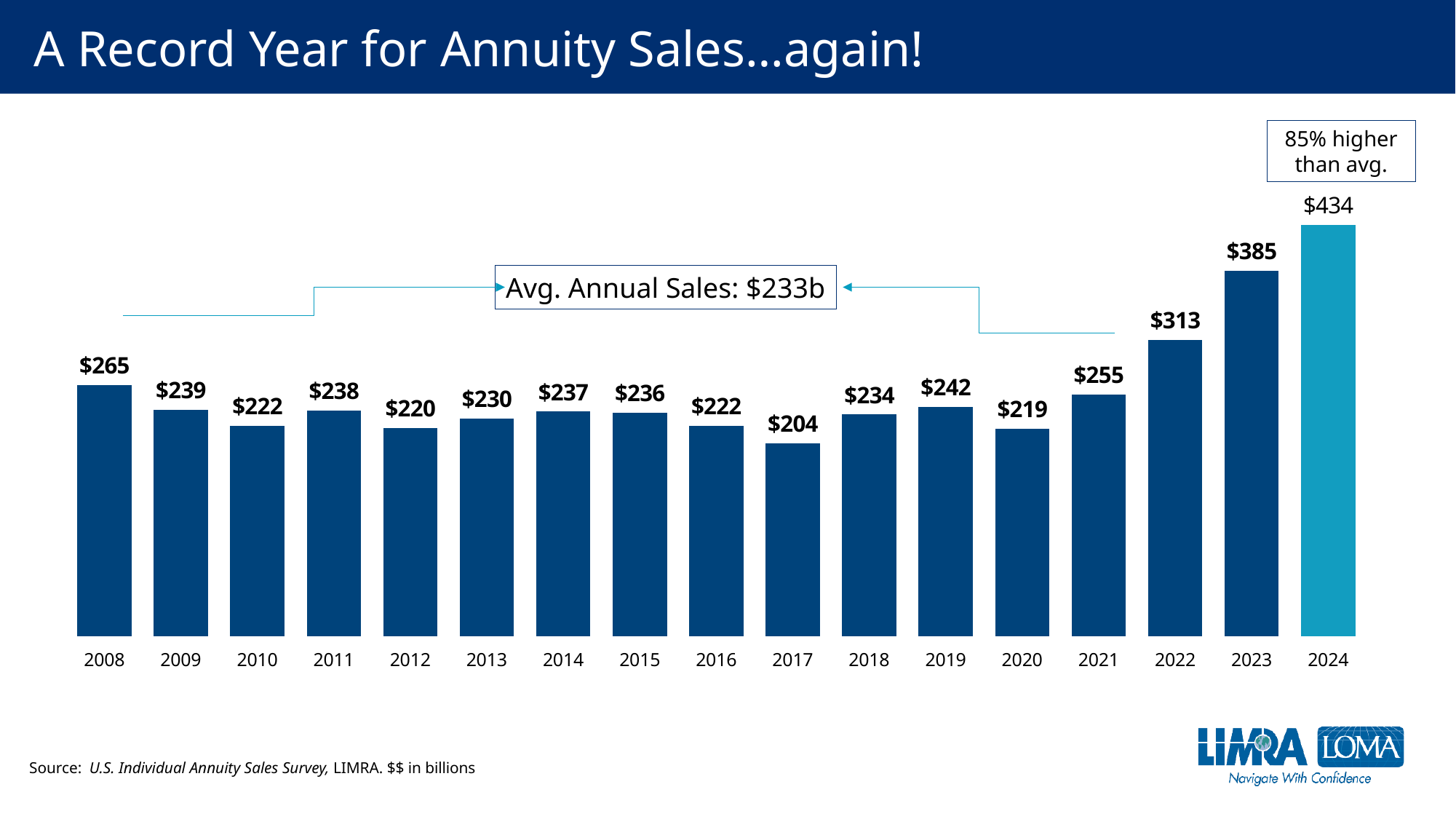
How many years are shown on the chart? 17 What is the annuity sales value for 2008? $265 What is the annuity sales value for 2017? $204 What is the difference between the 2022 and 2021 values? $58 What average annual sales figure is shown in the callout box on the chart? $233b What is the difference between the 2024 and 2023 values? $49 What kind of chart is shown on the slide? Bar chart Which year has the highest annuity sales? 2024 Do the values rise or fall from 2021 to 2024? Rise Which is larger, the value for 2019 or the value for 2020? 2019 What is the annuity sales value for 2024? $434 Which year has the lowest annuity sales? 2017